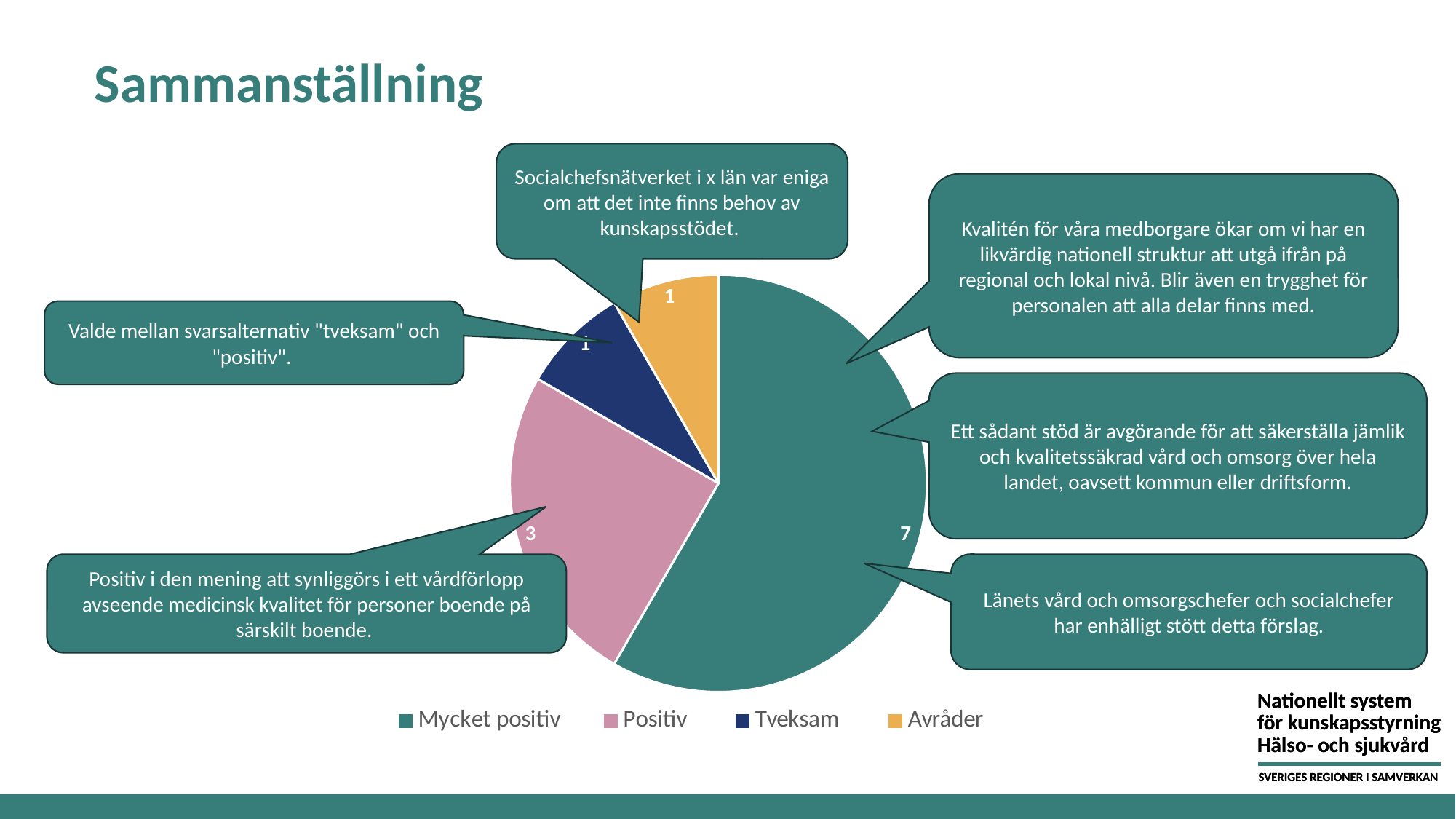
What is the value for Positiv in the pie chart? 3 What colour is the Avråder slice in the pie chart? yellow What is the value for Mycket positiv in the pie chart? 7 What is the total of all the slices in the pie chart? 12 Which is larger, the value for Positiv or the value for Tveksam? Positiv How many categories does the pie chart have? 4 What is the value for Avråder in the pie chart? 1 What share of the pie does the Positiv slice represent? 25% What is the value for Tveksam in the pie chart? 1 What is the difference between the values for Mycket positiv and Positiv? 4 Which category has the largest slice in the pie chart? Mycket positiv What kind of chart is shown on the slide? pie chart